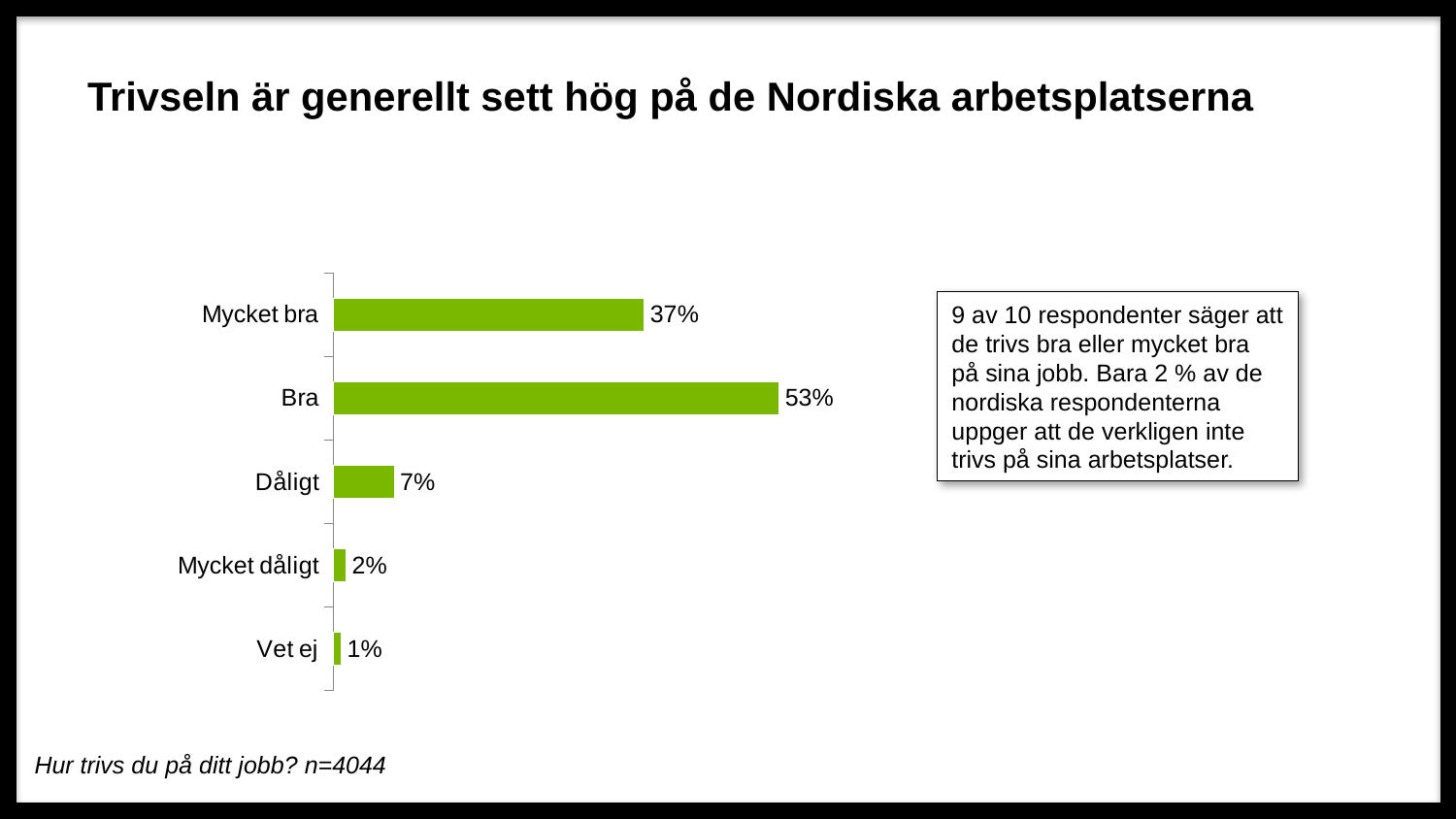
How many categories are shown in the chart? 5 What is the difference between the values for "Bra" and "Mycket bra"? 16% Which category has the highest value? Bra What is the value for "Mycket bra"? 37% Which category has the lowest value? Vet ej What kind of chart is shown on the slide? Bar chart Which is larger, the value for "Dåligt" or the value for "Mycket dåligt"? Dåligt What colour are the bars in the chart? Green What is the value for "Bra"? 53% What is the combined value of "Mycket bra" and "Bra"? 90% What is the value for "Dåligt"? 7% What is the value for "Vet ej"? 1%